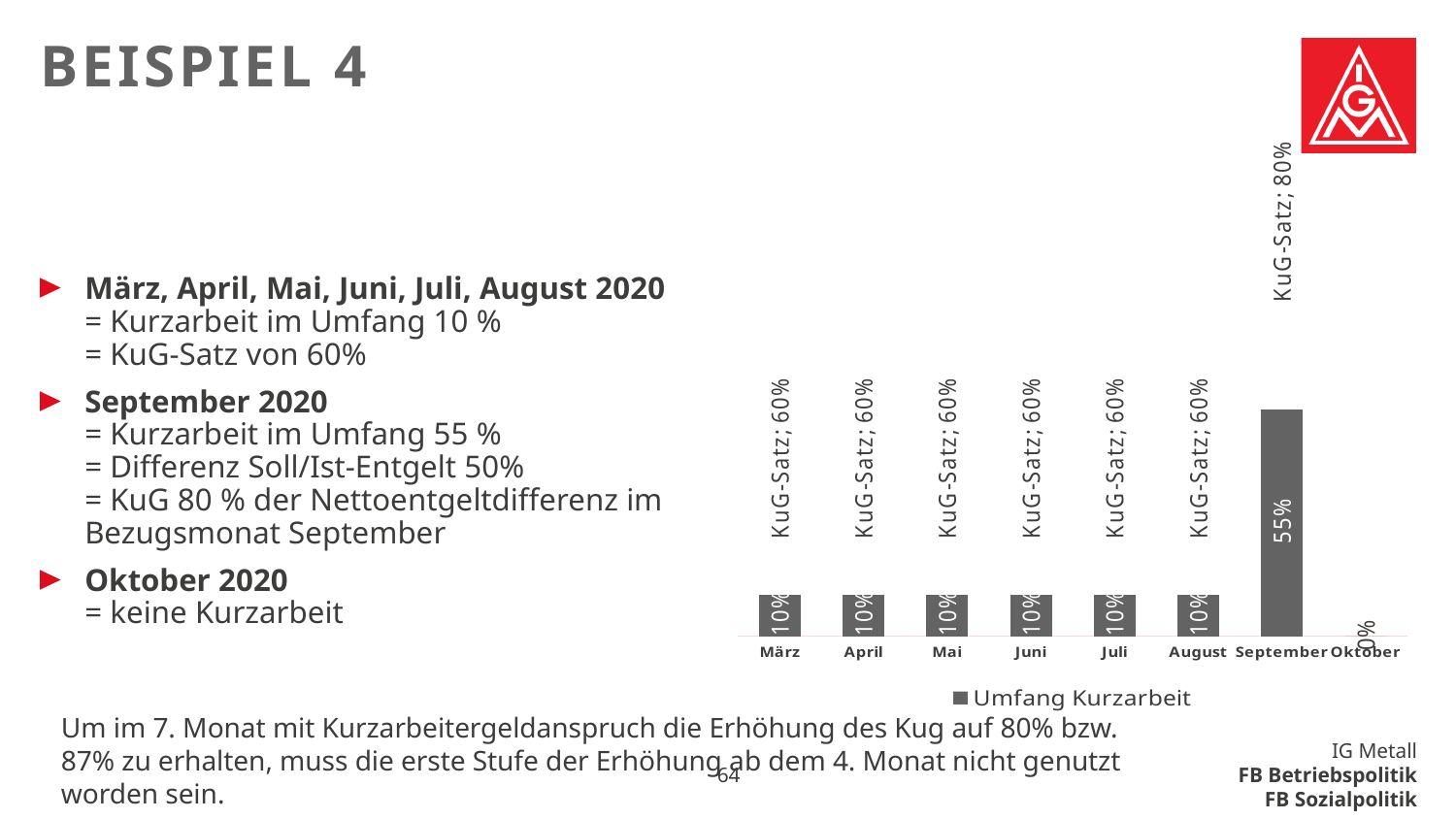
How many series does the legend list? 1 What KuG-Satz label is shown above the September bar? KuG-Satz; 80% What is the name of the series in the chart legend? Umfang Kurzarbeit Which month has the lowest value in the chart? Oktober Which month has the highest value in the chart? September What is the value for Oktober in the chart? 0% What kind of chart is shown on the slide? bar chart What is the value for September in the chart? 55% What is the difference between the values for September and August? 45% Which is larger, the value for Juli or the value for September? September What is the value for März in the chart? 10% How many months are shown on the x axis of the chart? 8